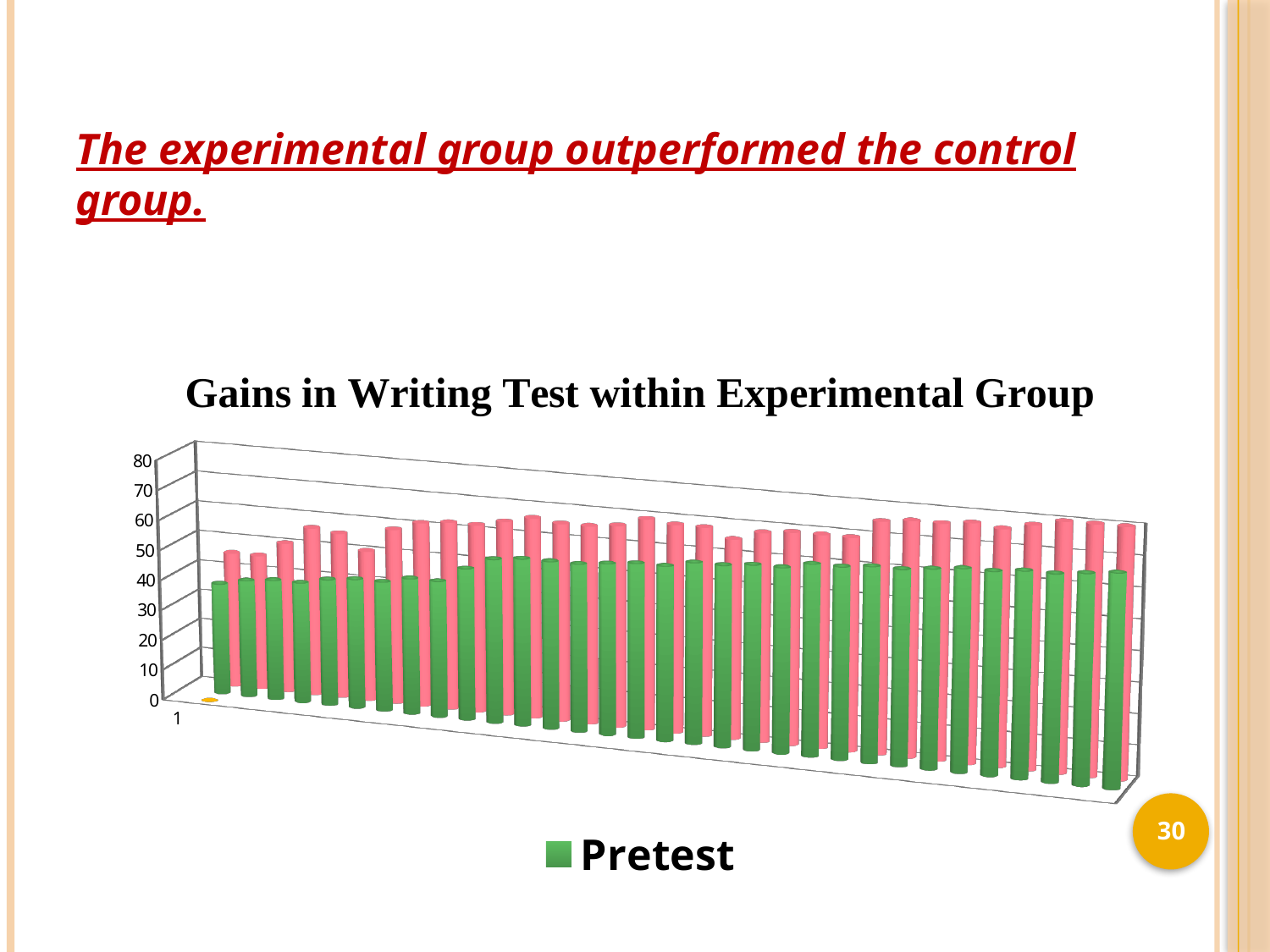
How many series does the chart's legend list? 1 Is the value of the first green Pretest bar greater or less than 60? less Is the value of the first pink bar greater or less than 30? greater What is the highest value shown on the vertical axis? 80 Is the value of the last green Pretest bar greater or less than 70? less What is the title of the chart? Gains in Writing Test within Experimental Group What kind of chart is shown on the slide? Bar chart Which series is named in the chart's legend? Pretest Are the green Pretest bars generally taller or shorter than the pink bars? Shorter